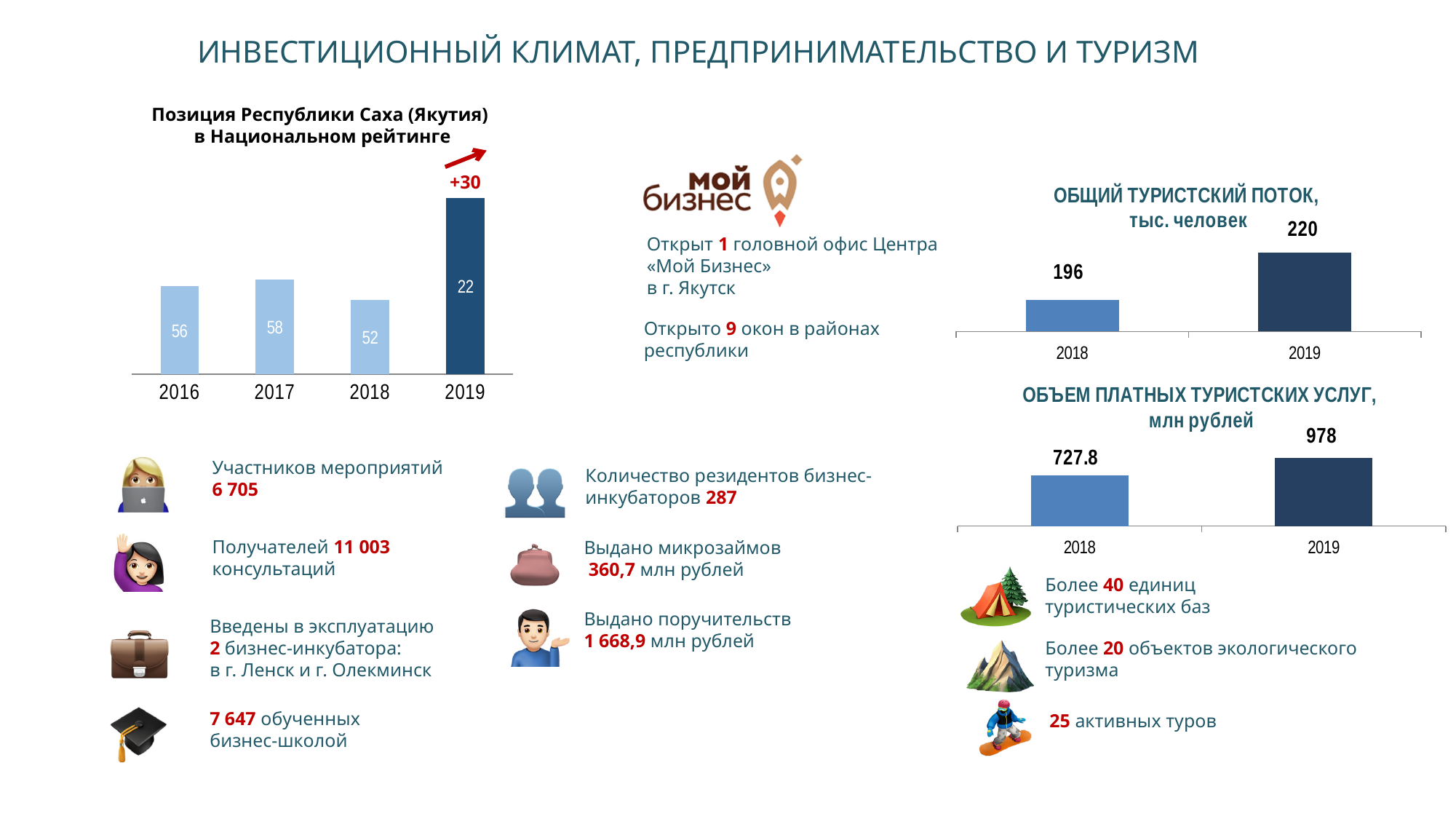
In the chart 'ОБЪЕМ ПЛАТНЫХ ТУРИСТСКИХ УСЛУГ, млн рублей', which year has the higher value? 2019 In the chart 'Позиция Республики Саха (Якутия) в Национальном рейтинге', what value is shown for 2019? 22 In the chart 'ОБЪЕМ ПЛАТНЫХ ТУРИСТСКИХ УСЛУГ, млн рублей', what is the difference between the 2019 and 2018 values? 250.2 In the chart 'Позиция Республики Саха (Якутия) в Национальном рейтинге', what value is shown for 2017? 58 What kind of chart is 'ОБЩИЙ ТУРИСТСКИЙ ПОТОК, тыс. человек'? bar chart In the chart 'ОБЩИЙ ТУРИСТСКИЙ ПОТОК, тыс. человек', do the values rise or fall from 2018 to 2019? rise In the chart 'Позиция Республики Саха (Якутия) в Национальном рейтинге', how many years are shown on the x axis? 4 In the chart 'ОБЩИЙ ТУРИСТСКИЙ ПОТОК, тыс. человек', by how much did the value increase from 2018 to 2019? 24 In the chart 'Позиция Республики Саха (Якутия) в Национальном рейтинге', what is the difference between the values for 2018 and 2019? 30 In the chart 'ОБЩИЙ ТУРИСТСКИЙ ПОТОК, тыс. человек', what is the value for 2018? 196 In the chart 'Позиция Республики Саха (Якутия) в Национальном рейтинге', which year has the smallest labelled value? 2019 In the chart 'ОБЪЕМ ПЛАТНЫХ ТУРИСТСКИХ УСЛУГ, млн рублей', what is the value for 2018? 727.8